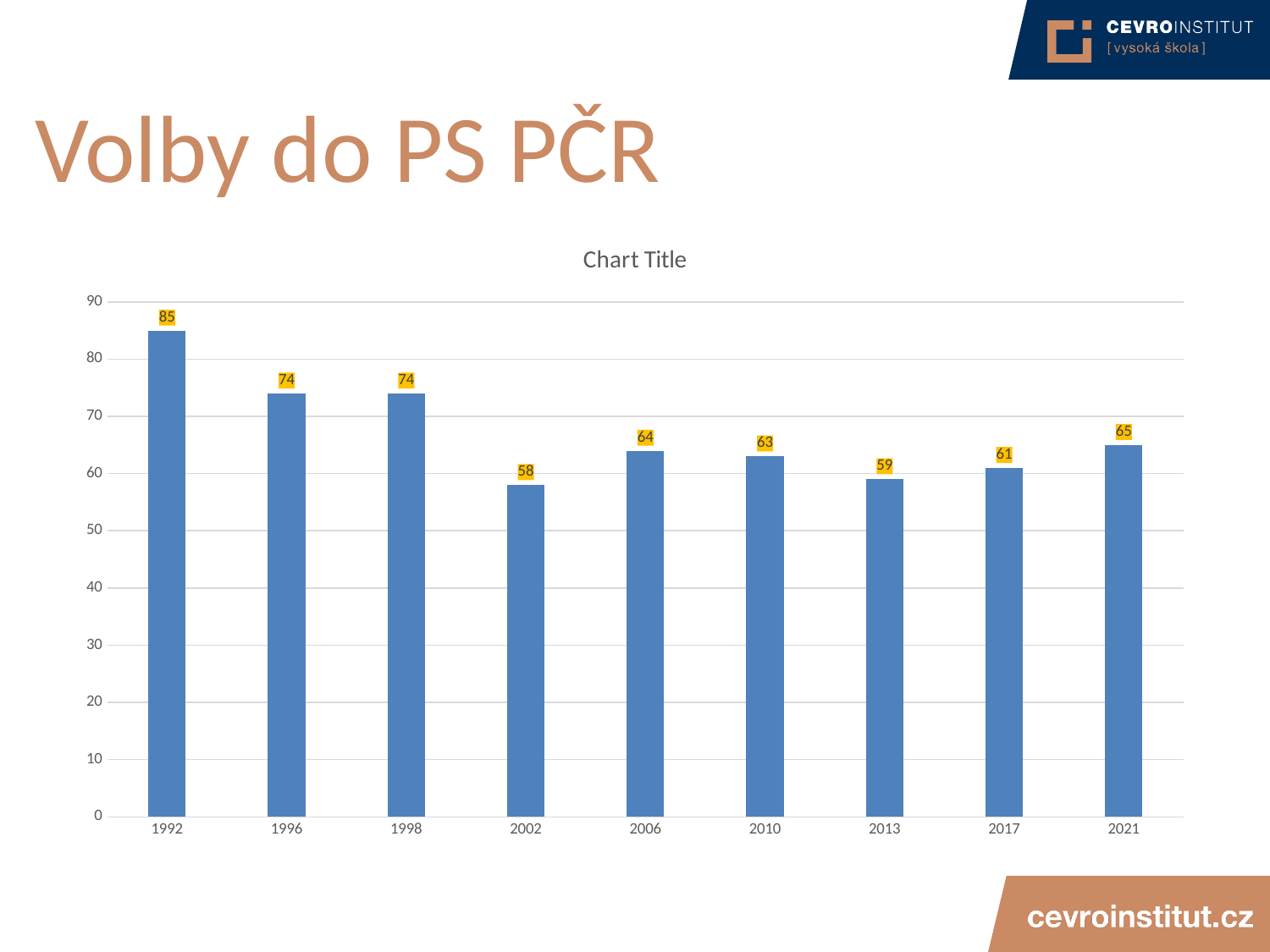
What kind of chart is shown on the slide? bar chart Which is larger, the value for 2006 or the value for 2013? 2006 Do the values rise or fall from 1992 to 2002? fall What is the value for 1992? 85 Which year has the highest value? 1992 Which year has the lowest value? 2002 What is the title shown above the chart? Chart Title How many years are shown on the x axis? 9 Is the value for 2010 greater or less than 70? less What is the difference between the values for 1992 and 2021? 20 What is the value for 2021? 65 What is the value for 2002? 58